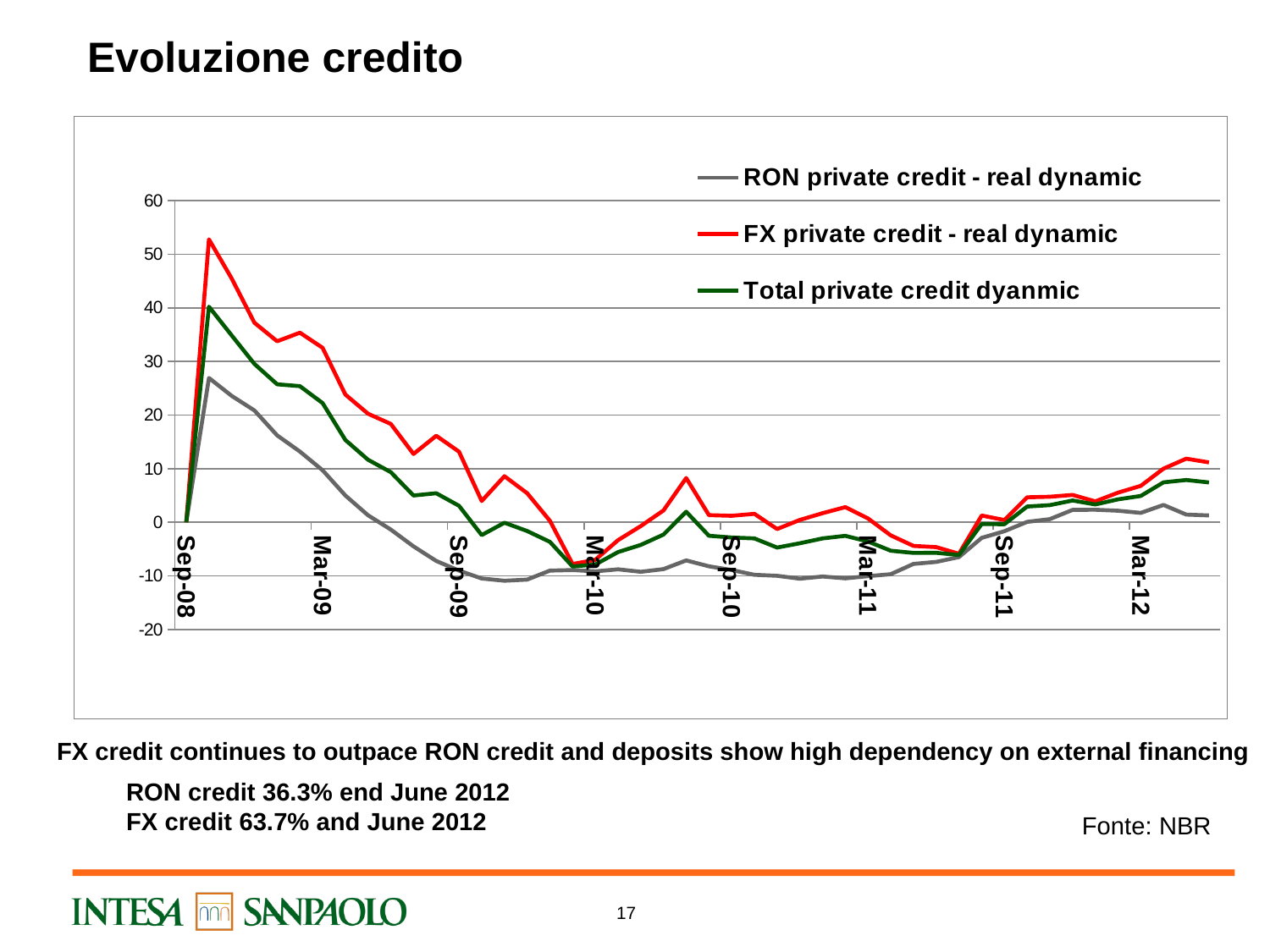
What kind of chart is shown on the slide? line chart Which series stays lowest across most of the chart? RON private credit - real dynamic Is the peak value of FX private credit - real dynamic greater or less than 50? greater Is the value of FX private credit - real dynamic at Mar-09 greater or less than 30? greater What colour is the line for FX private credit - real dynamic? red Is the peak value of RON private credit - real dynamic greater or less than 30? less Do the values of FX private credit - real dynamic rise or fall between Mar-09 and Mar-10? fall How many series does the legend list? 3 How many date labels are shown on the x axis? 8 Which series reaches the highest value on the chart? FX private credit - real dynamic At Sep-09, which is larger: FX private credit - real dynamic or Total private credit dyanmic? FX private credit - real dynamic